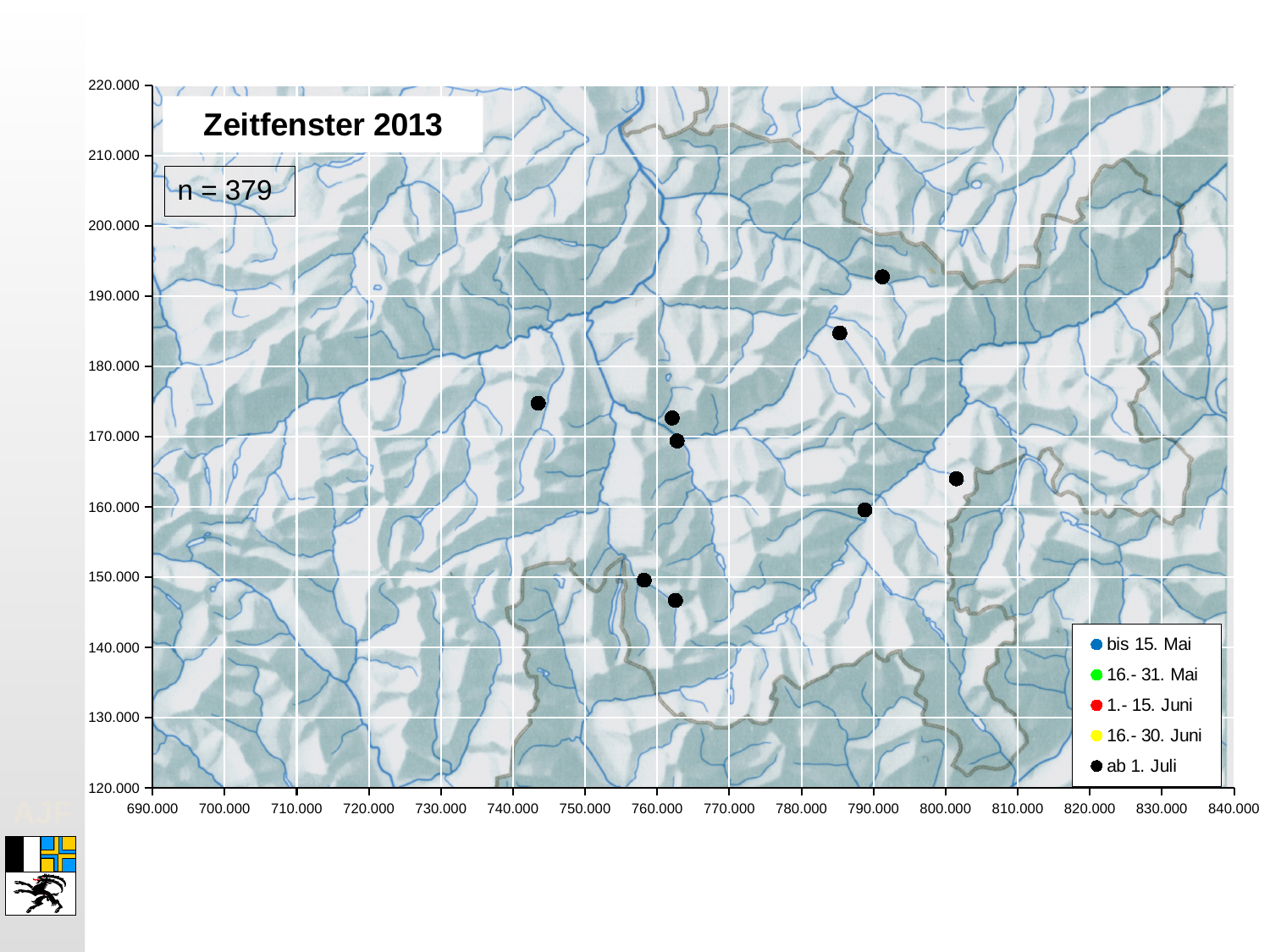
Is the y-value of the highest plotted point greater or less than 190.000? greater What kind of chart is shown on the slide? scatter chart What is the minimum value shown on the x axis? 690.000 What is the title of the chart? Zeitfenster 2013 Is the x-value of the leftmost plotted point greater or less than 750.000? less Which legend entry is shown with a black marker? ab 1. Juli What is the maximum value shown on the y axis? 220.000 Is the y-value of the lowest plotted point greater or less than 150.000? less How many series does the legend list? 5 What sample size (n) is stated on the chart? n = 379 How many black data points (ab 1. Juli) are plotted on the chart? 9